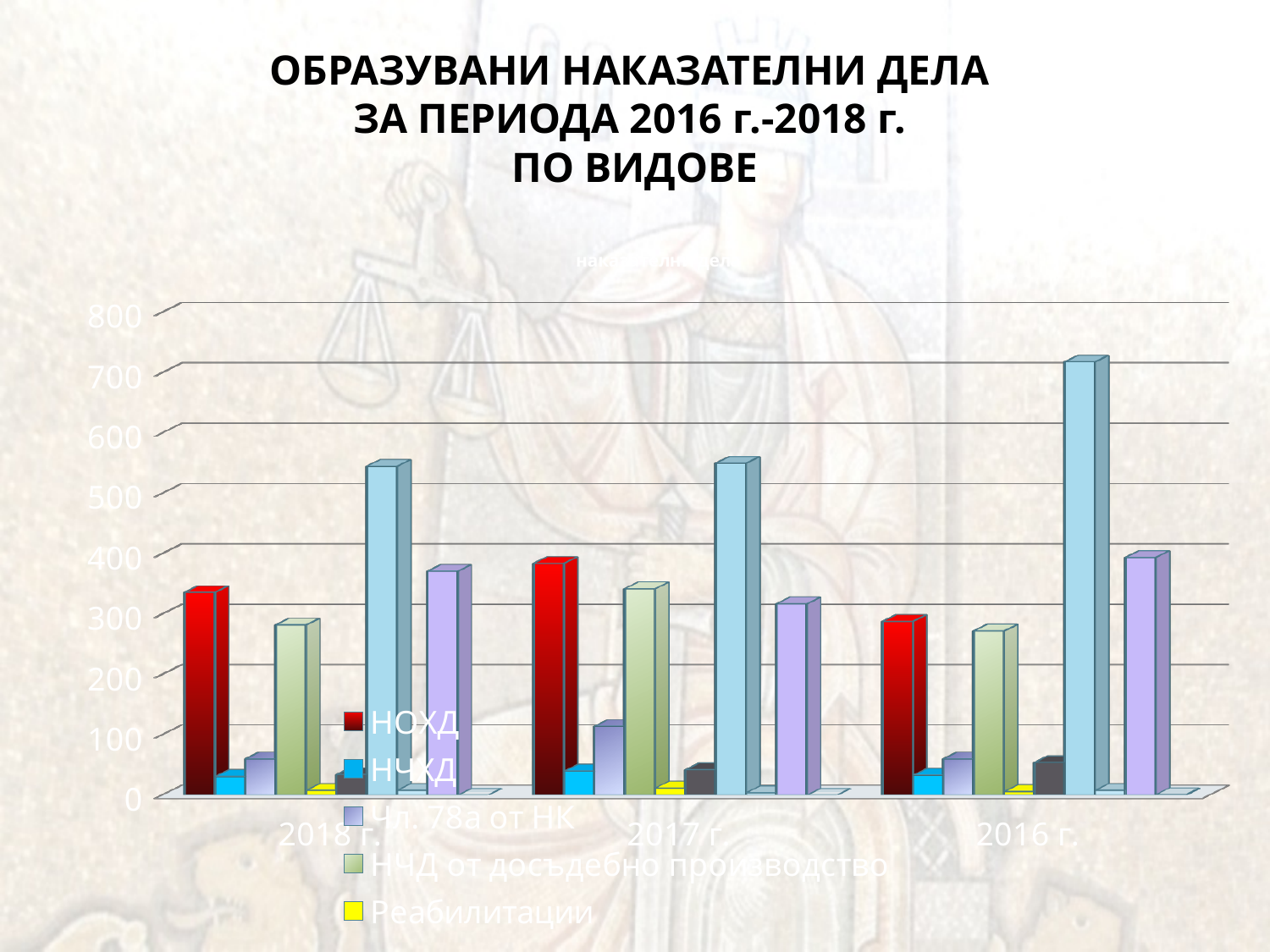
What kind of chart is shown on the slide? bar chart Which year has the lowest value for НОХД? 2016 г. Which is larger: the value for Чл. 78а от НК in 2017 г. or in 2018 г.? 2017 г. What colour are the bars for НОХД in the chart? red Is the value for НОХД in 2018 г. greater or less than 300? greater How many year categories are shown on the x axis of the chart? 3 Which year has the highest value for НОХД? 2017 г. Is the value for Реабилитации in 2018 г. greater or less than 100? less Which is larger: the value for НОХД in 2017 г. or in 2016 г.? 2017 г. Is the value for НЧД от досъдебно производство in 2017 г. greater or less than 300? greater